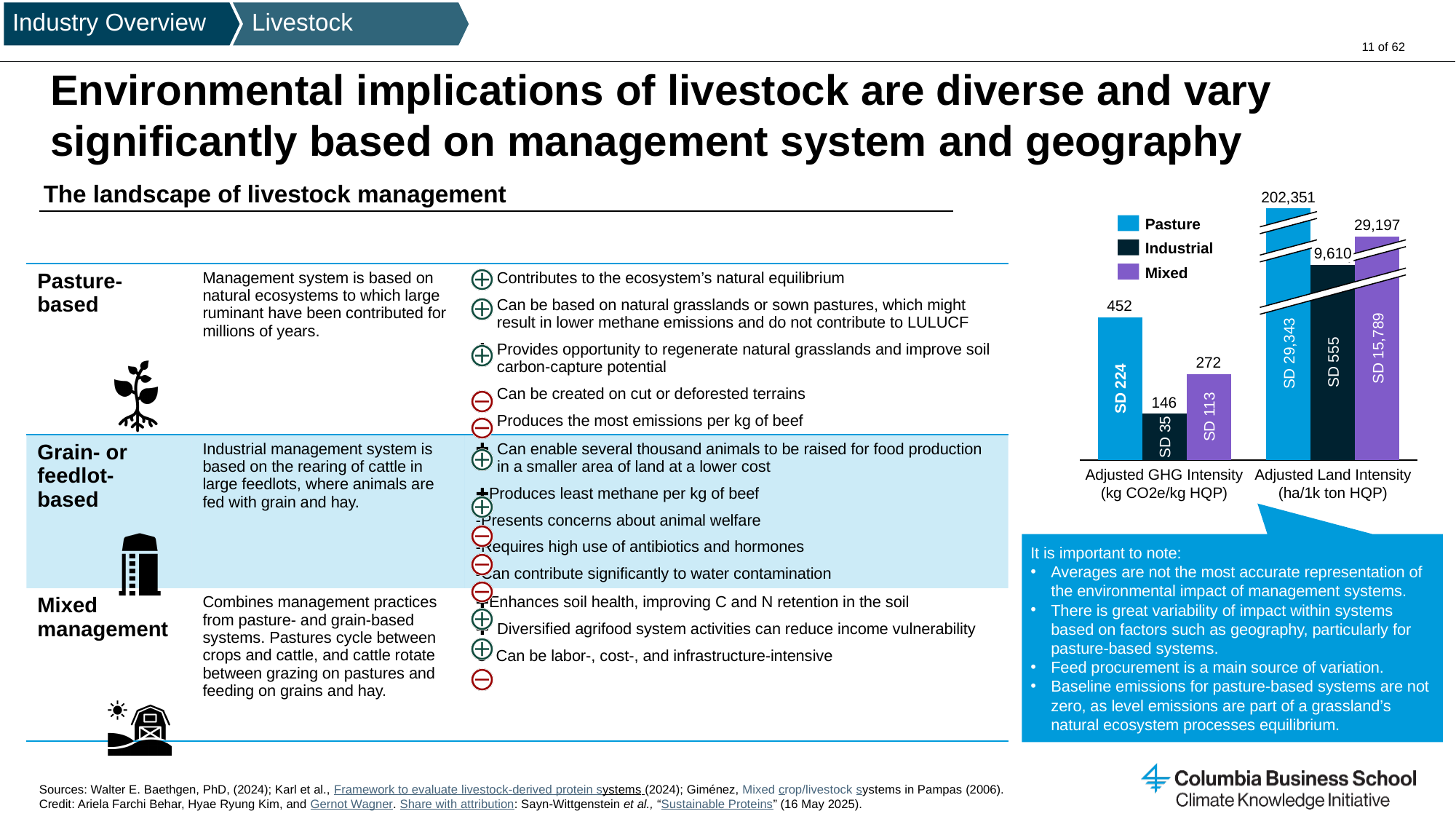
What is the Adjusted Land Intensity value for the Pasture series? 202,351 What kind of chart is shown on the slide? Bar chart What standard deviation is printed on the Industrial bar for Adjusted Land Intensity? SD 555 How many series does the legend list? 3 What is the difference between the Pasture and Industrial values for Adjusted GHG Intensity? 306 What is the Adjusted Land Intensity value for the Mixed series? 29,197 For Adjusted GHG Intensity, which is larger: the Mixed value or the Industrial value? Mixed What is the Adjusted GHG Intensity value for the Pasture series? 452 What is the Adjusted GHG Intensity value for the Industrial series? 146 What is the difference between the Mixed and Industrial values for Adjusted Land Intensity? 19,587 Which series has the lowest Adjusted Land Intensity? Industrial Which series has the highest Adjusted GHG Intensity? Pasture